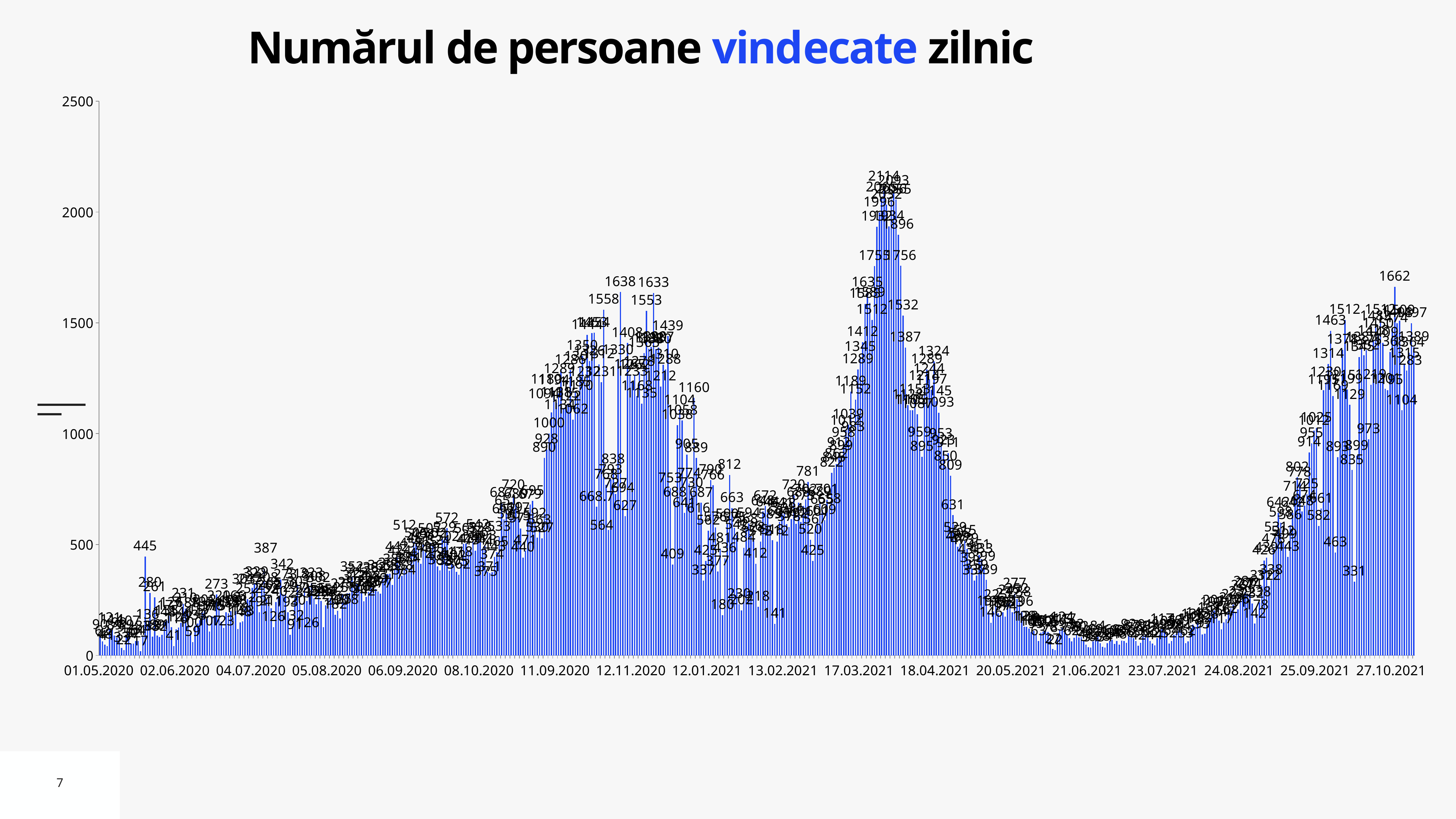
What kind of chart is shown on the slide? bar chart What is the value of the tallest bar near 27.10.2021? 1662 What is the value of the tallest bar in the wave around 12.11.2020? 1638 What is the difference between the overall peak value (2114) and the peak of the November 2020 wave (1638)? 476 Do the values rise or fall between 18.04.2021 and 21.06.2021? fall Is the peak value around 17.03.2021 greater or less than 2000? greater Which peak is higher: the one around 17.03.2021 or the one around 12.11.2020? 17.03.2021 What is the title of the chart? Numărul de persoane vindecate zilnic What is the value of the tallest bar in the chart? 2114 What is the highest value shown on the vertical axis? 2500 Do the values rise or fall between 24.08.2021 and 25.09.2021? rise Are the values around 21.06.2021 greater or less than 500? less